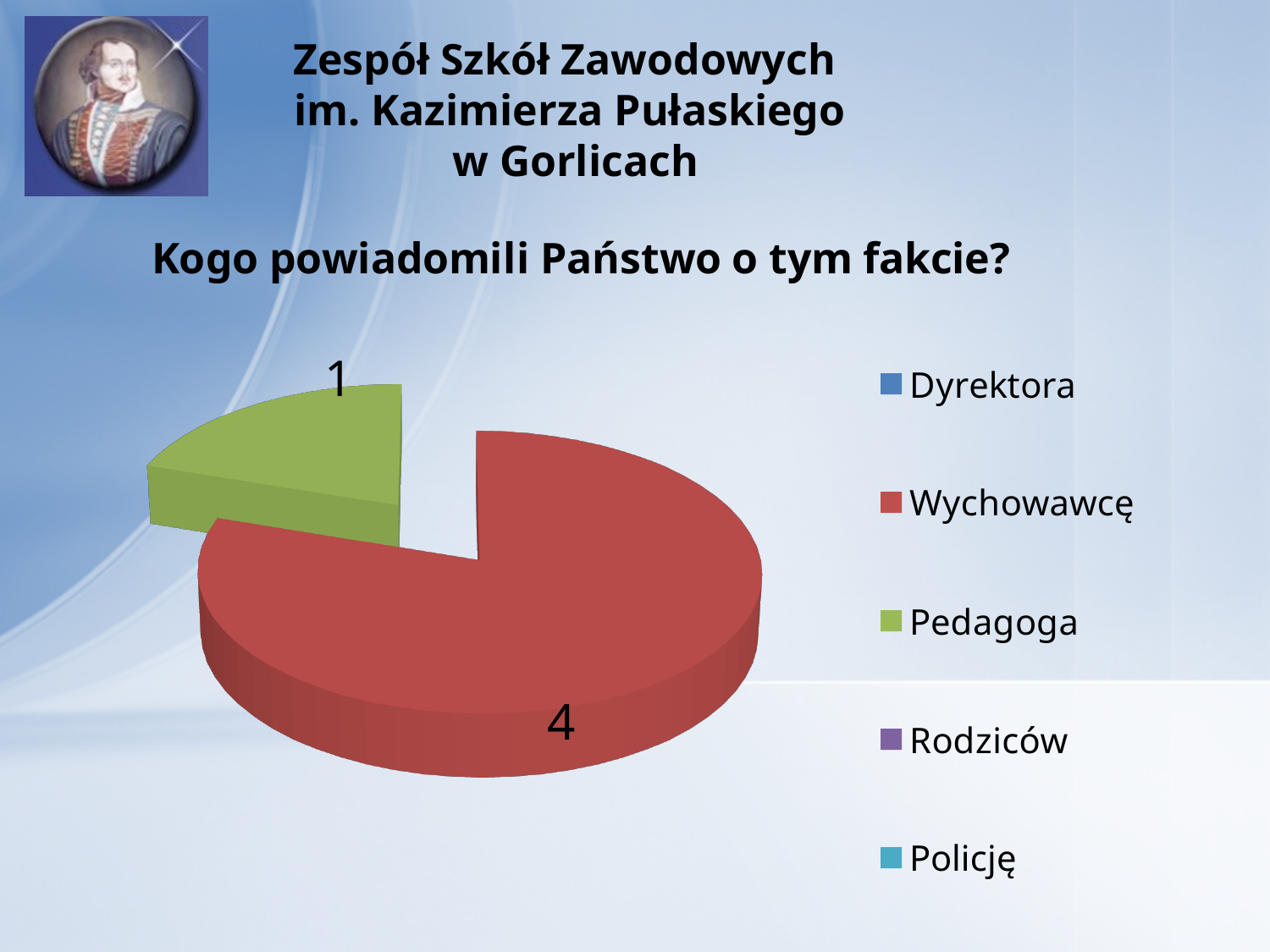
Which is larger, the value for Wychowawcę or the value for Pedagoga? Wychowawcę What type of chart is shown on the slide? pie chart What colour is the Pedagoga slice? green What is the difference between the values for Wychowawcę and Pedagoga? 3 How many slices with data labels are visible in the pie chart? 2 What is the value shown for the Wychowawcę slice? 4 Of the two slices shown, which category has the smaller value? Pedagoga Which category has the largest slice in the pie chart? Wychowawcę What share of the labelled pie total does the Wychowawcę slice represent? 80% What is the title of the chart? Kogo powiadomili Państwo o tym fakcie? How many entries does the legend list? 5 What is the value shown for the Pedagoga slice? 1